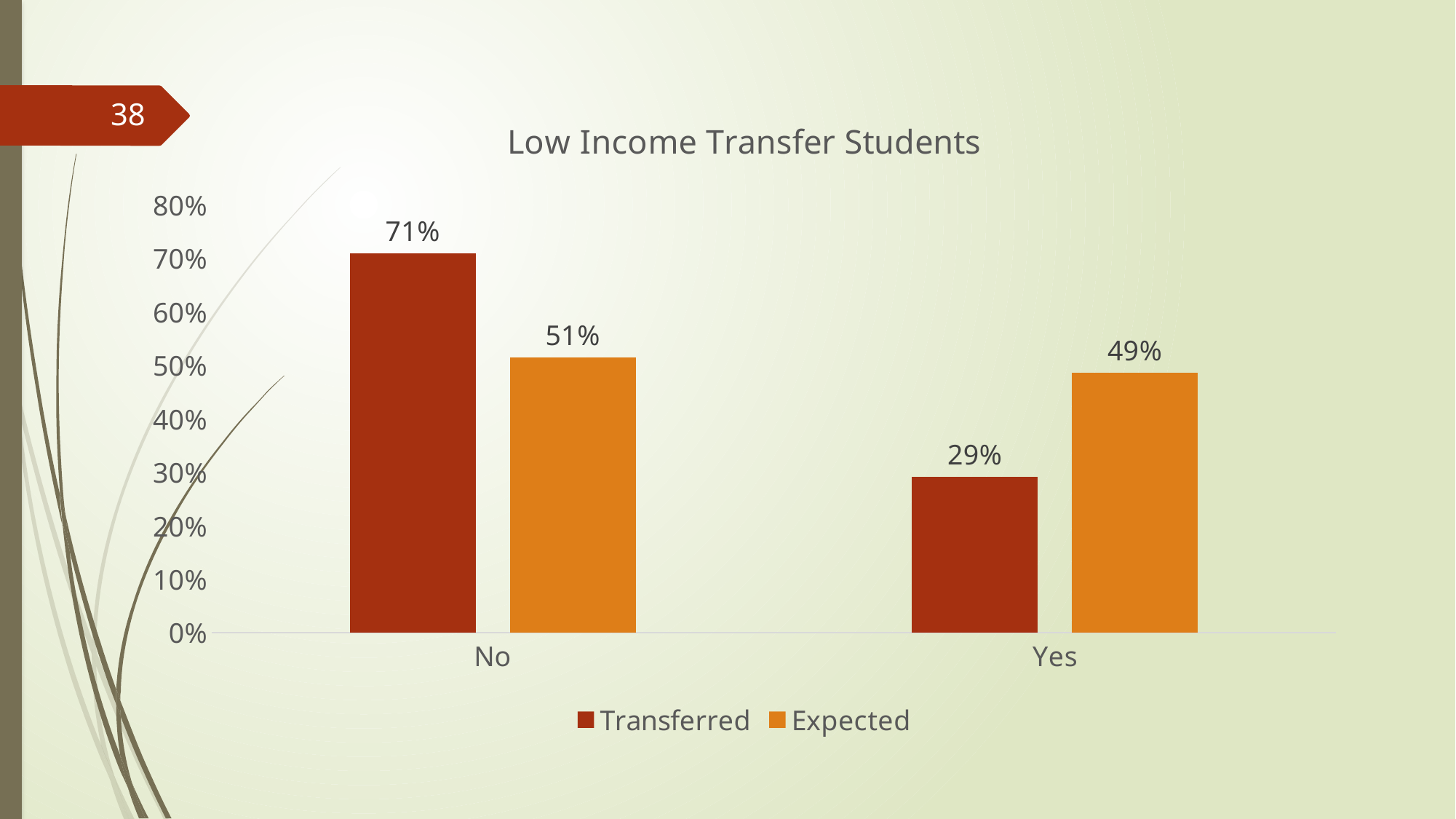
What is the title of the chart? Low Income Transfer Students For the Yes category, which is larger: Transferred or Expected? Expected Which category has the lowest Expected value? Yes What is the Transferred value for the No category? 71% How many series does the legend list? 2 How many categories are shown on the x axis? 2 What is the difference between the Transferred and Expected values for the No category? 20% Which category has the highest Transferred value? No What is the Expected value for the Yes category? 49% What is the Expected value for the No category? 51% What is the Transferred value for the Yes category? 29% What kind of chart is shown on the slide? Bar chart